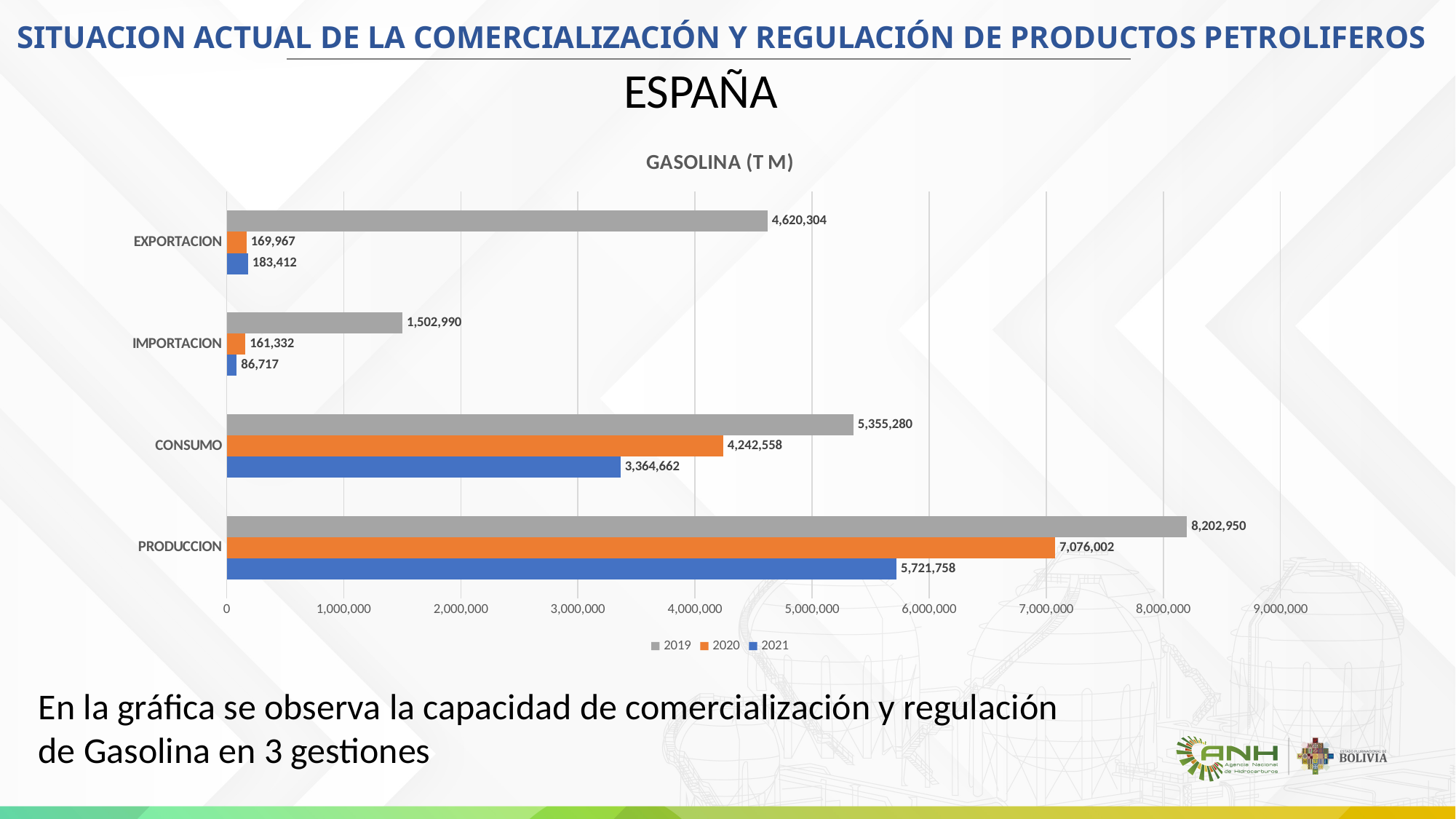
What is the 2019 value for EXPORTACION? 4,620,304 What kind of chart is shown on the slide? Bar chart How many series does the legend list? 3 Which category has the highest 2019 value? PRODUCCION How many categories are shown on the chart? 4 What is the 2020 value for CONSUMO? 4,242,558 Which category has the lowest 2021 value? IMPORTACION Which is larger for EXPORTACION, the 2020 value or the 2021 value? 2021 What is the difference between the 2019 and 2020 values for PRODUCCION? 1,126,948 What is the 2019 value for PRODUCCION in the GASOLINA (T M) chart? 8,202,950 What is the 2021 value for IMPORTACION? 86,717 What is the difference between the 2020 and 2021 values for CONSUMO? 877,896